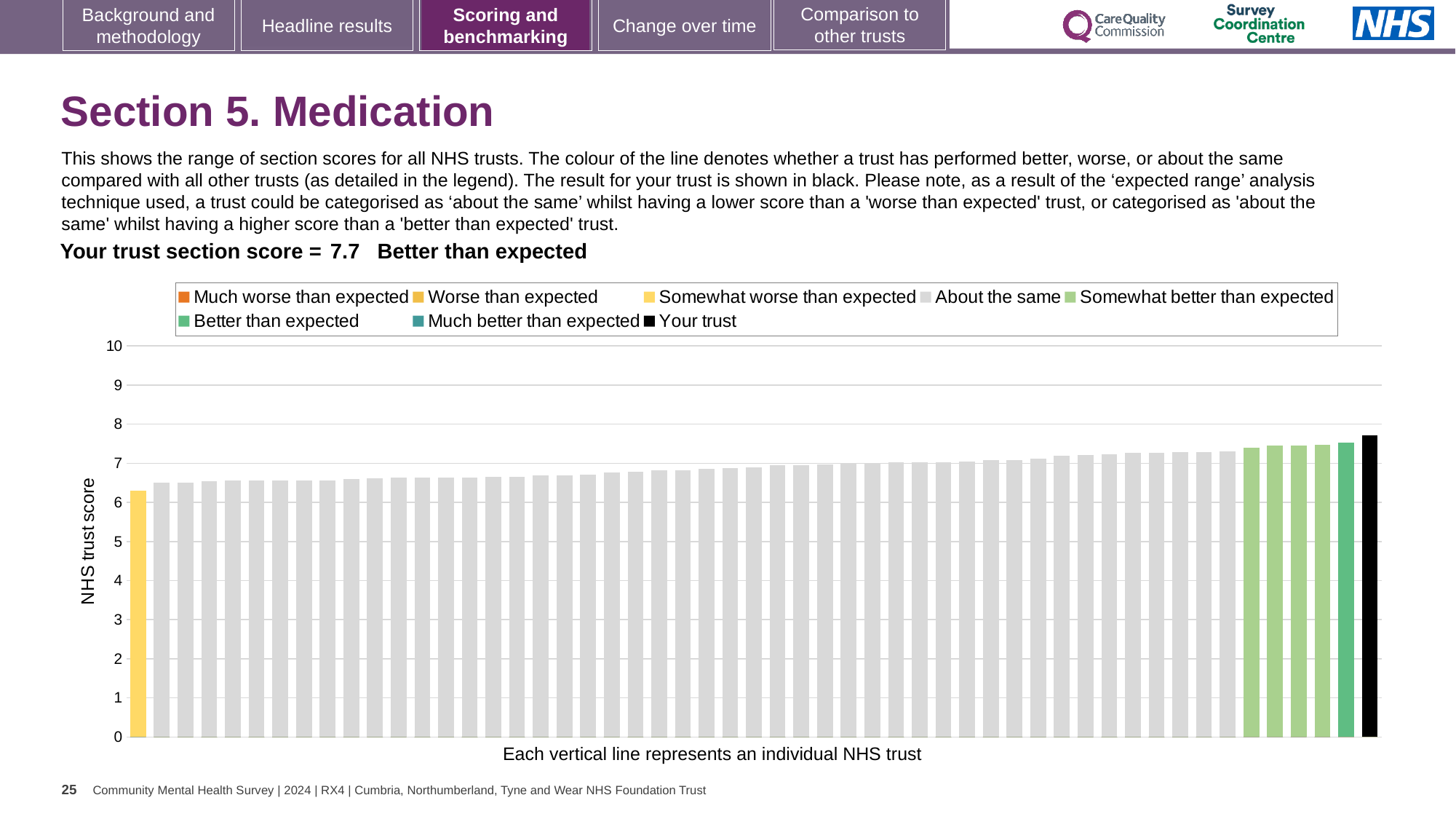
What is the label on the vertical axis of the chart? NHS trust score Which bar is the highest in the chart? the black 'Your trust' bar Is the value of the black 'Your trust' bar greater or less than 7? greater What is the section score for your trust shown on the slide? 7.7 How many entries does the chart legend list? 8 How many bars are coloured light green ('Somewhat better than expected')? 4 What category is your trust's section score placed in, according to the slide? Better than expected How many bars are coloured yellow ('Worse than expected')? 1 Which bar is the lowest in the chart? the leftmost yellow 'Somewhat worse than expected' bar Do the bar values rise or fall from left to right along the x axis? rise Is the value of the leftmost (yellow) bar greater or less than 7? less What kind of chart is shown on the slide? bar chart